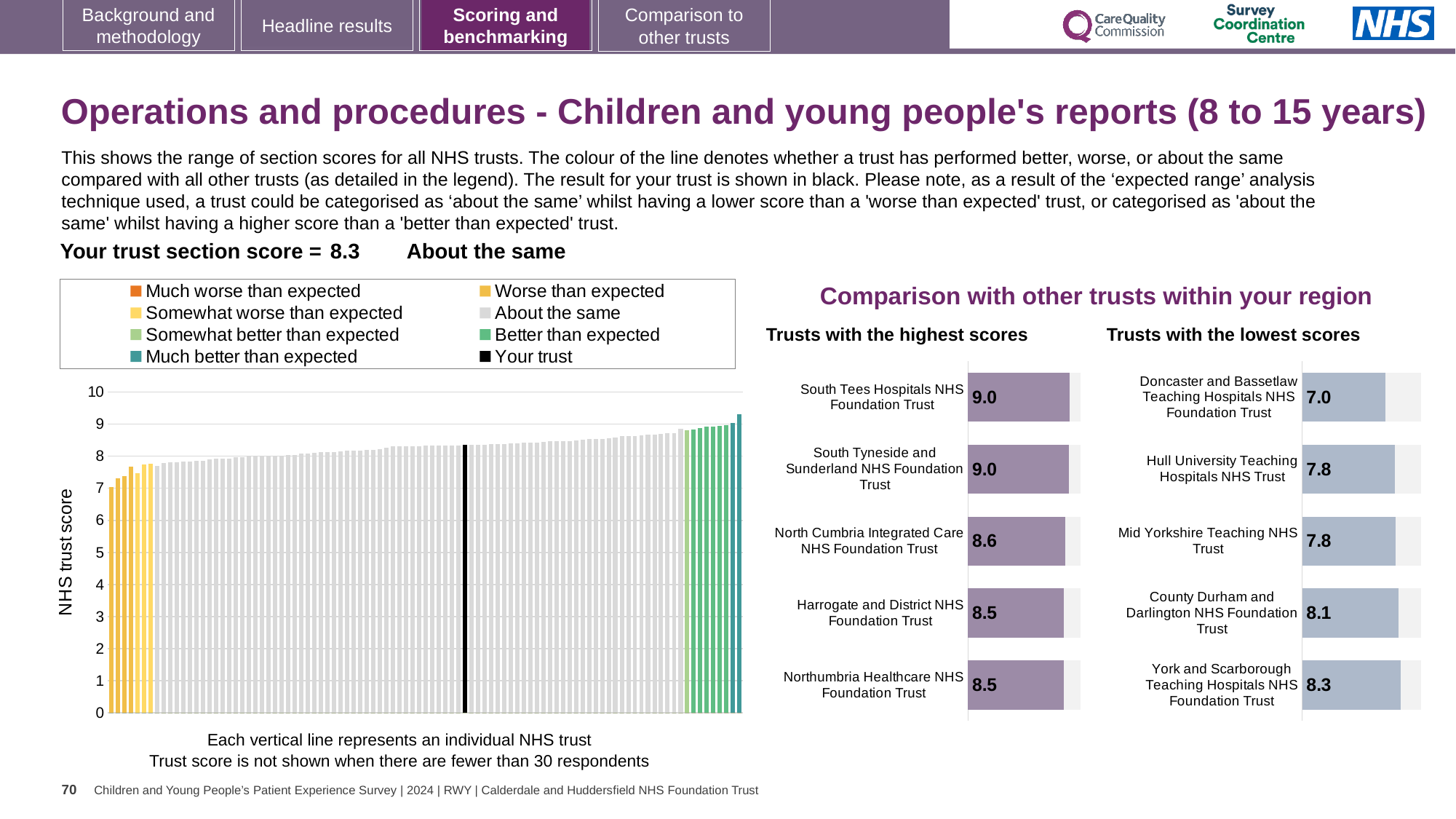
In the 'Trusts with the lowest scores' chart, which trust has the lowest score? Doncaster and Bassetlaw Teaching Hospitals NHS Foundation Trust In the 'Trusts with the lowest scores' chart, what is the difference between the scores of York and Scarborough Teaching Hospitals NHS Foundation Trust and Doncaster and Bassetlaw Teaching Hospitals NHS Foundation Trust? 1.3 In the 'Trusts with the lowest scores' chart, which trust has the highest score? York and Scarborough Teaching Hospitals NHS Foundation Trust What kind of chart is the NHS trust score chart on the left? Bar chart In the 'Trusts with the highest scores' chart, what is the score for North Cumbria Integrated Care NHS Foundation Trust? 8.6 In the NHS trust score chart on the left, what colour is used for the bar representing 'Your trust'? Black In the NHS trust score chart on the left, do the bars rise or fall from left to right? Rise How many trusts are shown in the 'Trusts with the highest scores' chart? 5 In the NHS trust score chart on the left, is the value of the leftmost (lowest) bar greater or less than 8? less How many entries does the legend of the NHS trust score chart on the left list? 8 In the 'Trusts with the lowest scores' chart, what is the score for Hull University Teaching Hospitals NHS Trust? 7.8 In the 'Trusts with the highest scores' chart, which has the larger score: South Tees Hospitals NHS Foundation Trust or Northumbria Healthcare NHS Foundation Trust? South Tees Hospitals NHS Foundation Trust